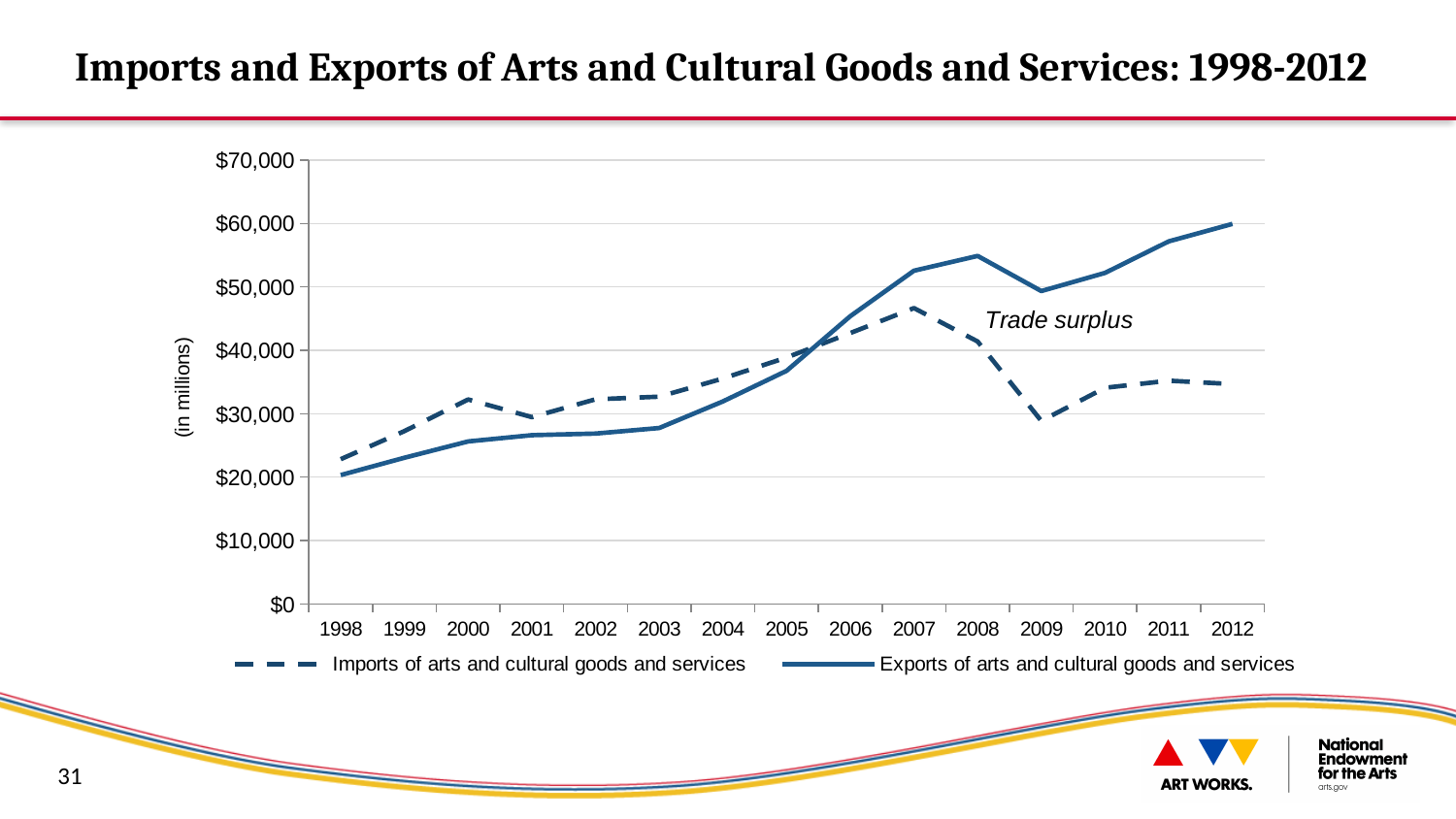
In 2012, which is larger: imports or exports of arts and cultural goods and services? Exports What annotation text is written on the chart between the two lines? Trade surplus In which year do exports of arts and cultural goods and services reach their highest value? 2012 In which year do imports of arts and cultural goods and services reach their highest value? 2007 Is the value for imports in 2009 greater or less than $40,000? less In 2000, which is larger: imports or exports of arts and cultural goods and services? Imports Is the value for exports in 2012 greater or less than $50,000? greater Do exports of arts and cultural goods and services generally rise or fall from 1998 to 2012? Rise In which year are exports of arts and cultural goods and services lowest? 1998 How many series does the legend list? 2 How many years are plotted along the x axis? 15 What kind of chart is shown on the slide? Line chart